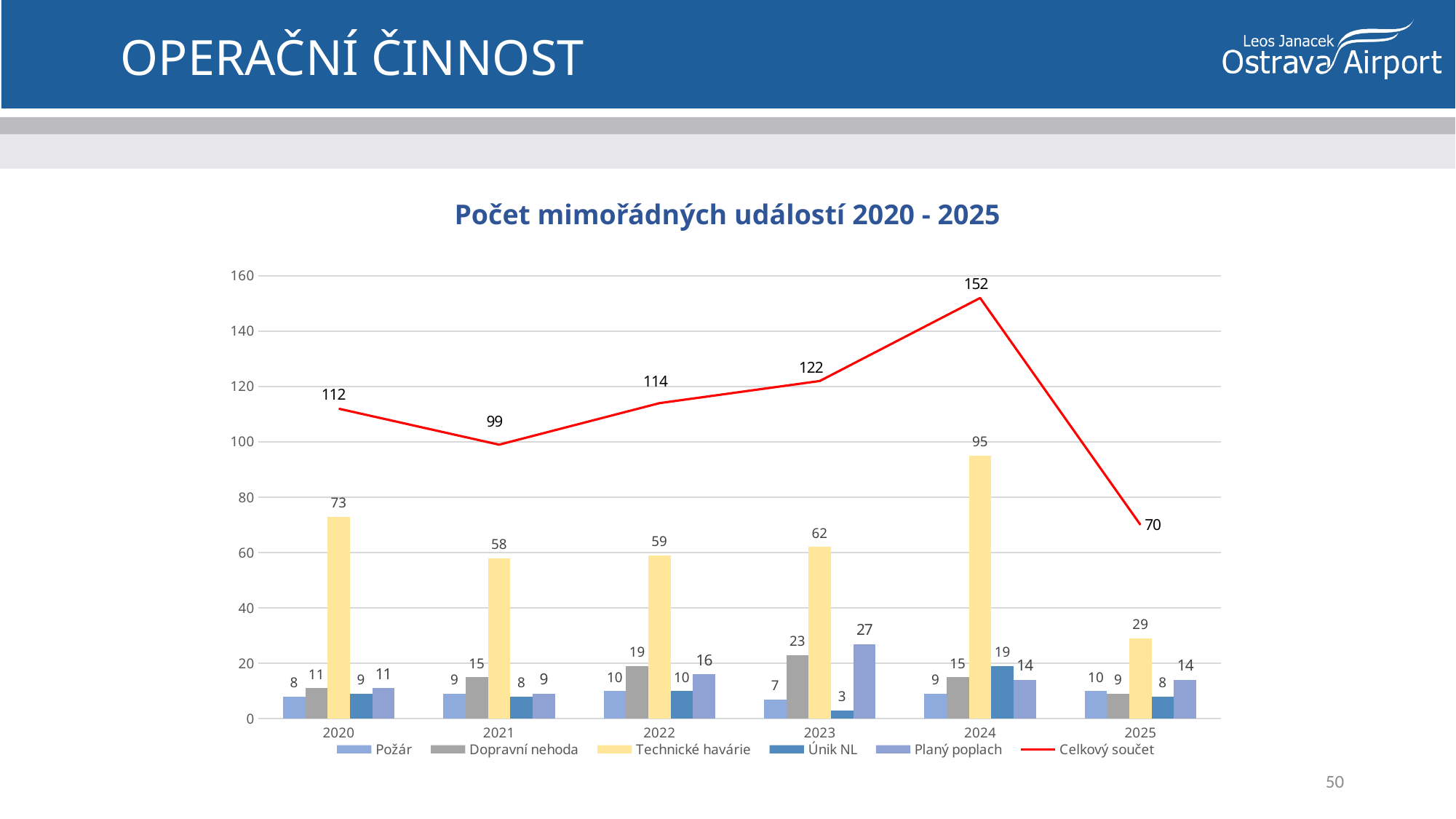
What is the value of Planý poplach in 2023? 27 How many series does the legend list? 6 What is the difference between the Celkový součet values for 2024 and 2025? 82 What is the value of Technické havárie in 2024? 95 In which year is the Celkový součet line lowest? 2025 In which year is the Celkový součet line highest? 2024 How many years are shown on the x axis? 6 Is the Celkový součet value for 2023 greater or less than 100? greater What kind of chart is shown on the slide? Combined bar and line chart Which is larger: Dopravní nehoda in 2023 or Dopravní nehoda in 2022? Dopravní nehoda in 2023 What is the title of the chart? Počet mimořádných událostí 2020 - 2025 What is the Celkový součet value for 2021? 99